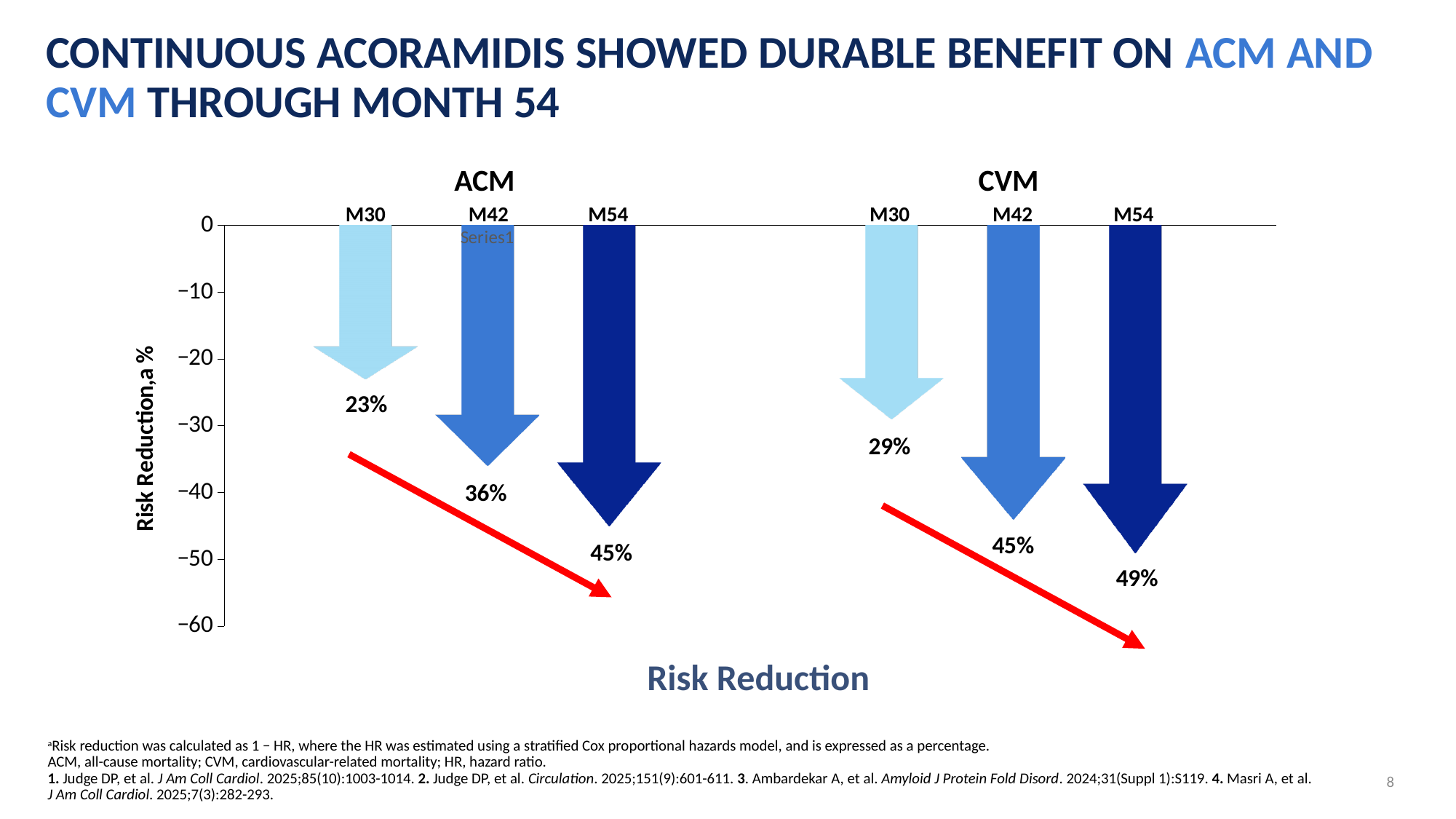
How many time points are shown for each of ACM and CVM? 3 Does the risk reduction for ACM increase or decrease from M30 to M54? Increase What is the risk reduction for CVM at M30? 29% Which time point shows the smallest risk reduction for ACM? M30 What is the label of the vertical axis? Risk Reduction, % Which time point shows the largest risk reduction for CVM? M54 What is the risk reduction for ACM at M54? 45% What is the risk reduction for CVM at M54? 49% What is the difference between the ACM risk reduction at M54 and at M30? 22% What is the difference between the CVM and ACM risk reduction at M42? 9% What is the risk reduction for ACM at M30? 23% Which is larger, the risk reduction for ACM at M42 or for CVM at M42? CVM at M42